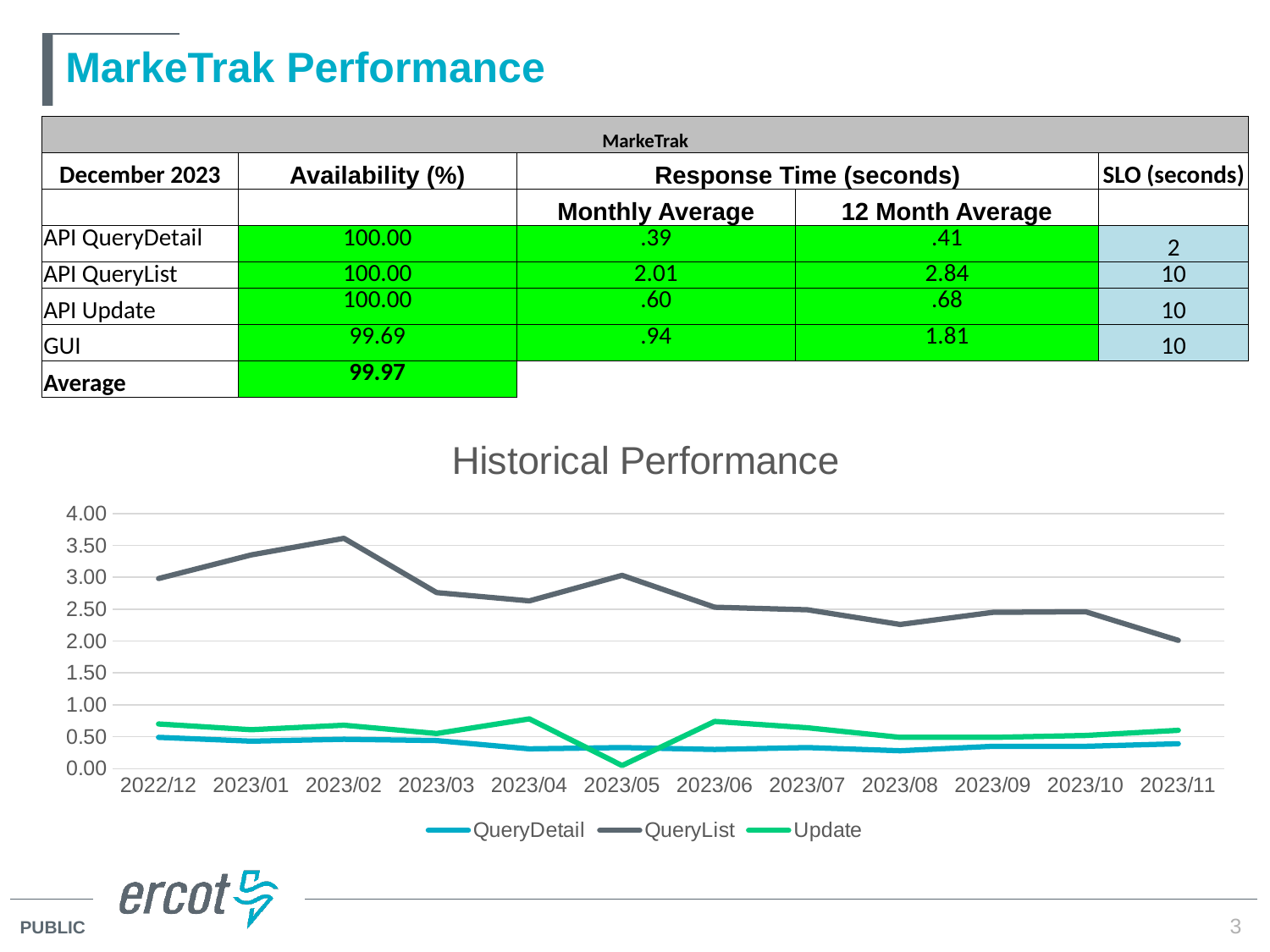
In the Historical Performance chart, is the QueryList value for 2023/03 greater or less than 2.50? greater In the Historical Performance chart, in which month does the QueryList series reach its highest value? 2023/02 In the Historical Performance chart, does the QueryList series generally rise or fall from 2023/02 to 2023/11? fall In the Historical Performance chart, is the QueryList value for 2023/08 greater or less than 2.50? less How many months are shown on the x axis of the Historical Performance chart? 12 In the Historical Performance chart, which series has the highest values throughout the period? QueryList What kind of chart is the Historical Performance chart? line chart In the Historical Performance chart, which is larger at 2023/04: the Update value or the QueryDetail value? Update In the Historical Performance chart, in which month does the QueryList series reach its lowest value? 2023/11 In the Historical Performance chart, is the Update value for 2023/05 greater or less than 0.50? less How many series does the legend of the Historical Performance chart list? 3 In the Historical Performance chart, in which month does the Update series reach its lowest value? 2023/05